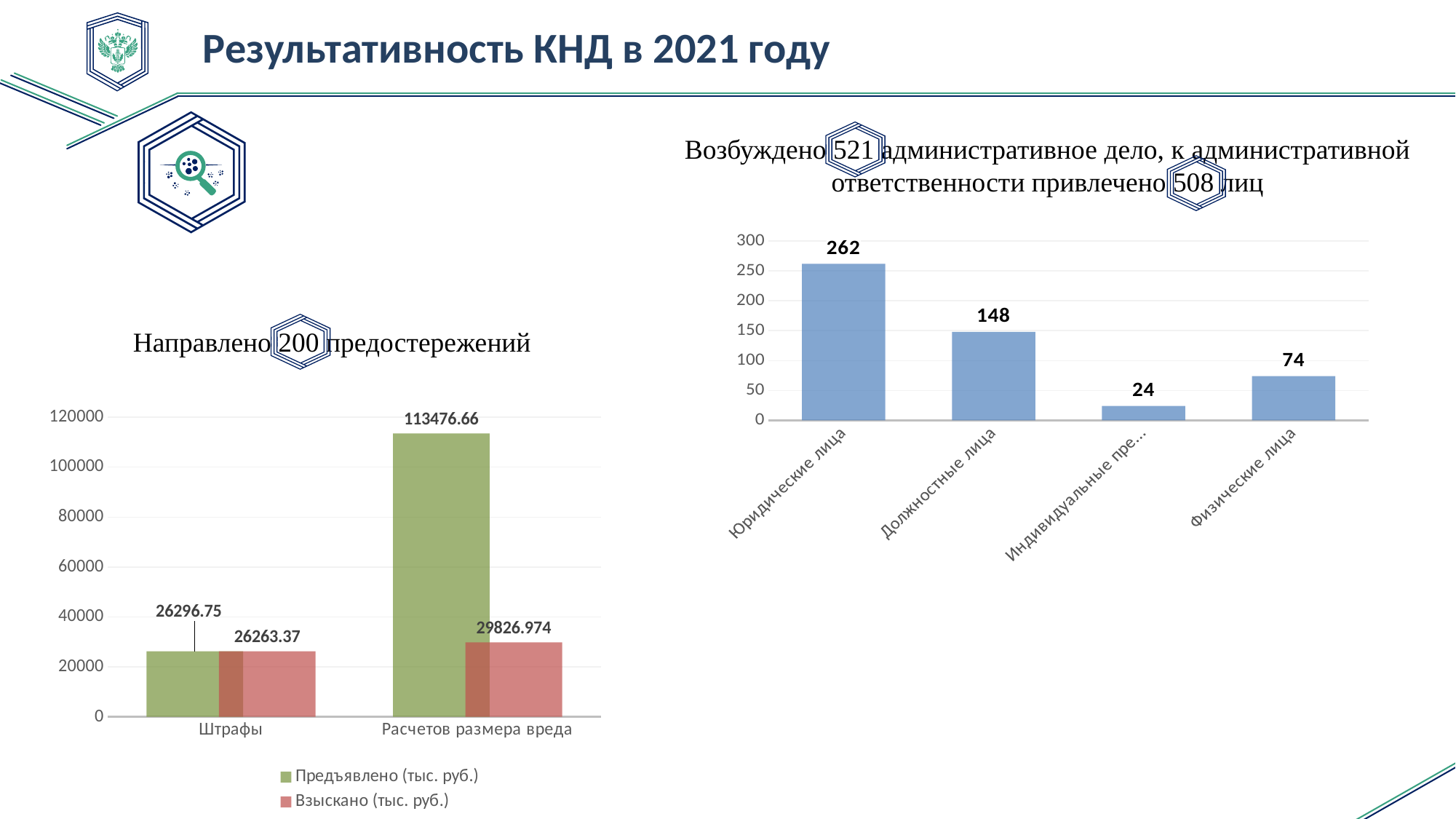
In the chart on the right, what is the value for Юридические лица? 262 In the bottom-left chart, what is the value of Предъявлено (тыс. руб.) for Штрафы? 26296.75 In the chart on the right, which category has the highest value? Юридические лица In the chart on the right, what is the value for Физические лица? 74 In the chart on the right, what is the difference between Юридические лица and Должностные лица? 114 In the bottom-left chart, what is the difference between Предъявлено and Взыскано for Штрафы? 33.38 In the bottom-left chart, what colour are the Взыскано (тыс. руб.) bars? Red In the bottom-left chart, which is larger for Расчетов размера вреда: Предъявлено or Взыскано? Предъявлено In the bottom-left chart, what is the value of Взыскано (тыс. руб.) for Расчетов размера вреда? 29826.974 In the chart on the right, how many categories are shown? 4 In the bottom-left chart, how many series does the legend list? 2 In the bottom-left chart, what is the value of Предъявлено (тыс. руб.) for Расчетов размера вреда? 113476.66